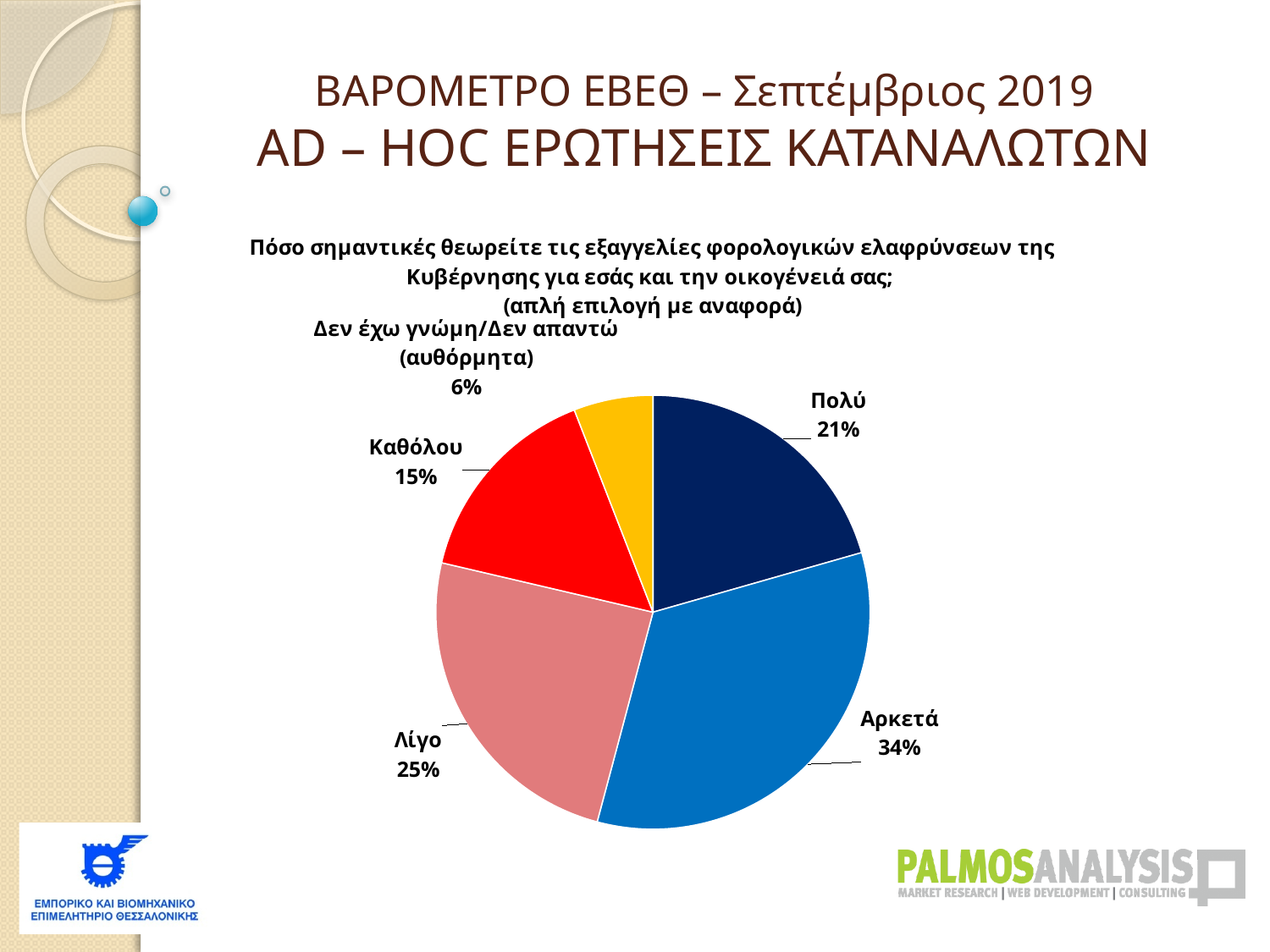
What percentage of respondents answered "Λίγο"? 25% What percentage of respondents answered "Καθόλου"? 15% Which response has the smallest share of the pie? Δεν έχω γνώμη/Δεν απαντώ (αυθόρμητα) What kind of chart is shown on the slide? pie chart What colour is the slice for "Καθόλου"? red What is the difference in percentage points between "Αρκετά" and "Πολύ"? 13 What percentage of respondents answered "Πολύ"? 21% Which is larger, the share for "Λίγο" or the share for "Καθόλου"? Λίγο What percentage of respondents answered "Δεν έχω γνώμη/Δεν απαντώ (αυθόρμητα)"? 6% Which response has the largest share of the pie? Αρκετά What percentage of respondents answered "Αρκετά"? 34% How many slices does the pie chart have? 5